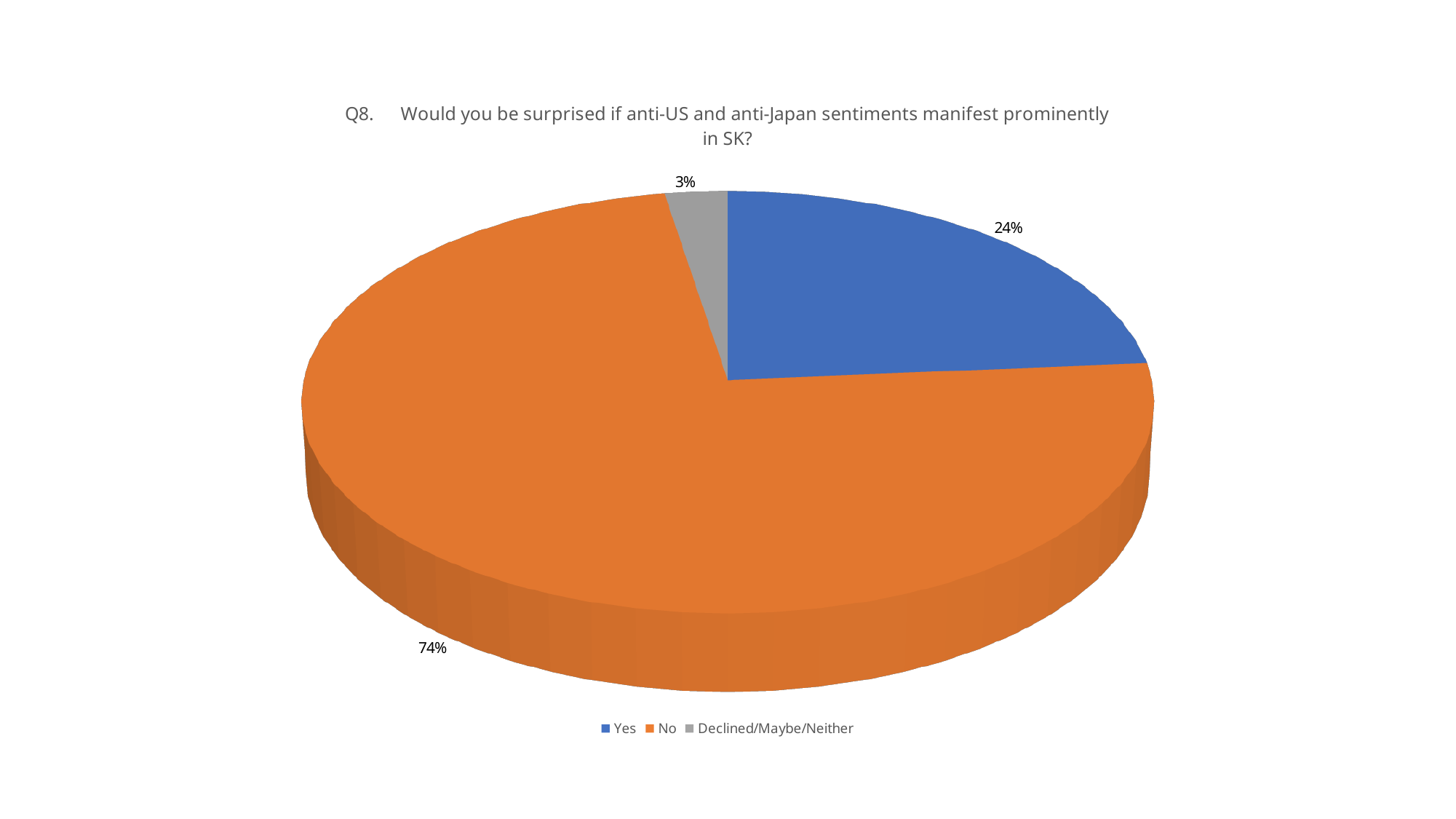
What colour is the "No" slice? Orange Which slice is larger, "Yes" or "Declined/Maybe/Neither"? Yes What kind of chart is shown on the slide? Pie chart What is the title of the chart? Q8. Would you be surprised if anti-US and anti-Japan sentiments manifest prominently in SK? Which response has the largest share of the pie? No What is the difference in percentage points between the "No" and "Yes" slices? 50 What percentage of respondents answered "No"? 74% How many categories does the pie chart show? 3 Which response has the smallest share of the pie? Declined/Maybe/Neither What percentage of respondents answered "Yes"? 24% What share of the pie does the "Yes" slice represent? 24% What percentage of respondents are in the "Declined/Maybe/Neither" category? 3%